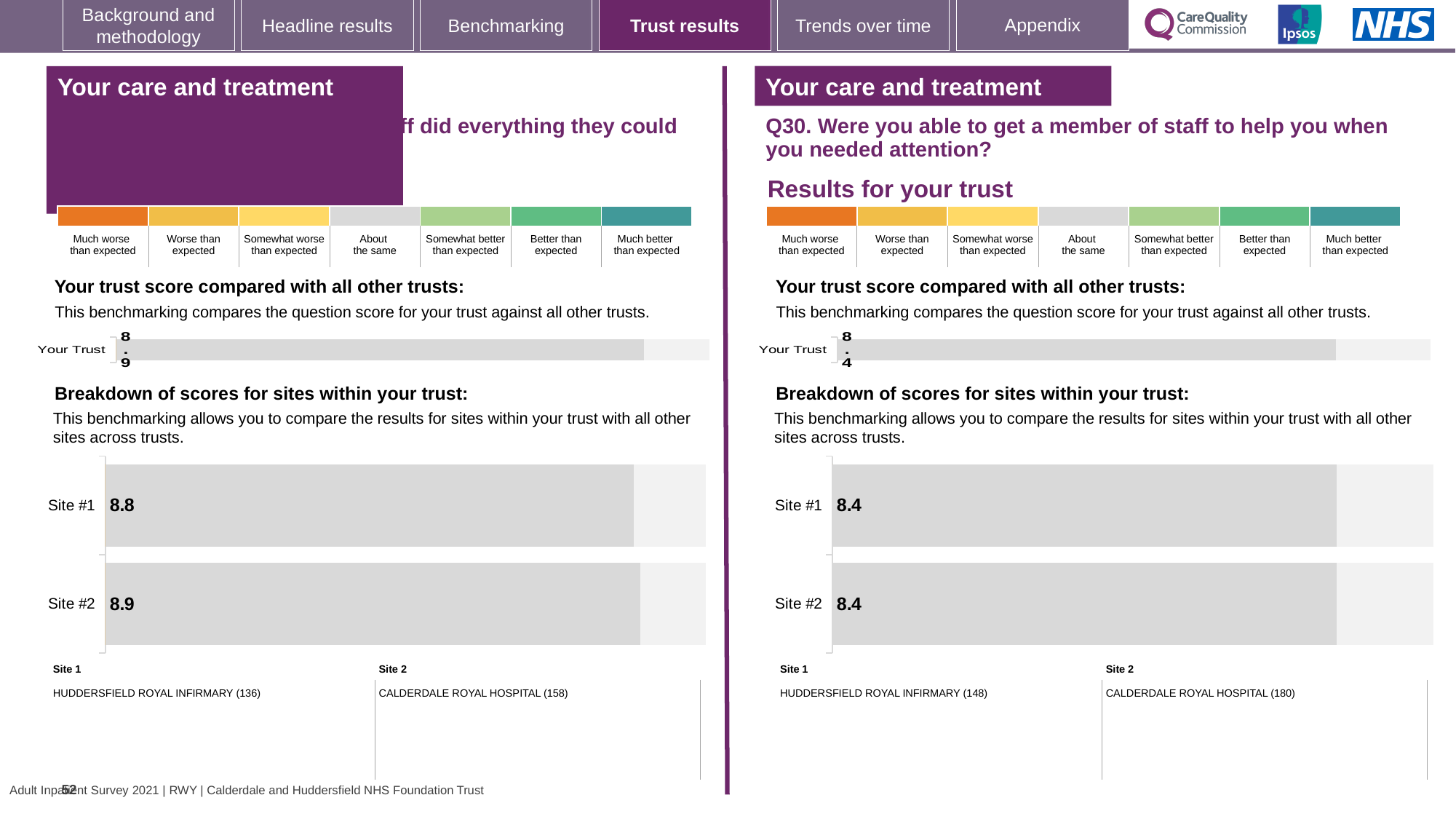
In the 'Breakdown of scores for sites within your trust' chart on the left half of the slide, what is the score for Site #1? 8.8 In the Q30 'Breakdown of scores for sites within your trust' chart on the right half of the slide, what is the score for Site #2? 8.4 In the 'Your trust score compared with all other trusts' chart on the left half of the slide, what is the score for Your Trust? 8.9 In the 'Breakdown of scores for sites within your trust' chart on the left half of the slide, which site has the higher score? Site #2 In the 'Breakdown of scores for sites within your trust' chart on the left half of the slide, what is the difference between the Site #2 and Site #1 scores? 0.1 In the Q30 'Your trust score compared with all other trusts' chart on the right half of the slide, what is the score for Your Trust? 8.4 In the Q30 'Breakdown of scores for sites within your trust' chart on the right half of the slide, how many sites are shown? 2 Is the Site #1 score in the Q30 site breakdown chart on the right half of the slide larger than, smaller than, or equal to the Site #2 score? Equal What type of chart is the 'Breakdown of scores for sites within your trust' chart on the left half of the slide? Bar chart Which site is listed as Site 1 beneath the Q30 site breakdown chart on the right half of the slide? HUDDERSFIELD ROYAL INFIRMARY (148) In the Q30 'Breakdown of scores for sites within your trust' chart on the right half of the slide, what is the score for Site #1? 8.4 In the 'Breakdown of scores for sites within your trust' chart on the left half of the slide, what is the score for Site #2? 8.9